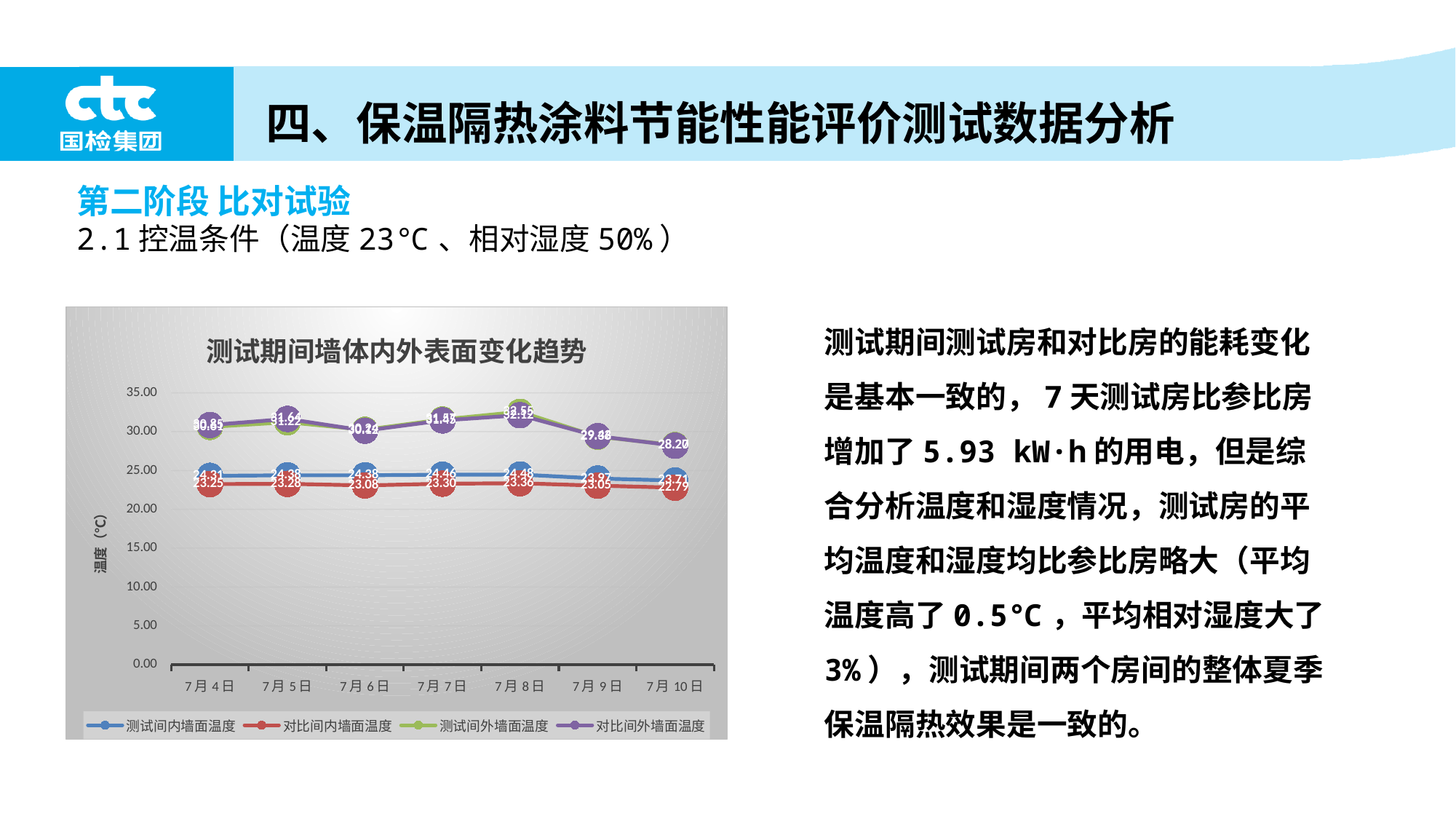
Is the value for 对比间外墙面温度 on 7月8日 greater or less than 30.00? greater On which date is 测试间内墙面温度 lowest? 7月10日 What is the value of 测试间内墙面温度 on 7月4日? 24.31 On which date is 对比间内墙面温度 highest? 7月8日 What is the title of the chart? 测试期间墙体内外表面变化趋势 What is the value of 对比间外墙面温度 on 7月10日? 28.20 Does 测试间内墙面温度 rise or fall from 7月8日 to 7月10日? fall How many series does the chart legend list? 4 What is the value of 对比间内墙面温度 on 7月10日? 22.79 What kind of chart is shown on the slide? line chart How many dates are plotted along the x axis? 7 What is the difference between 测试间内墙面温度 and 对比间内墙面温度 on 7月4日? 1.06